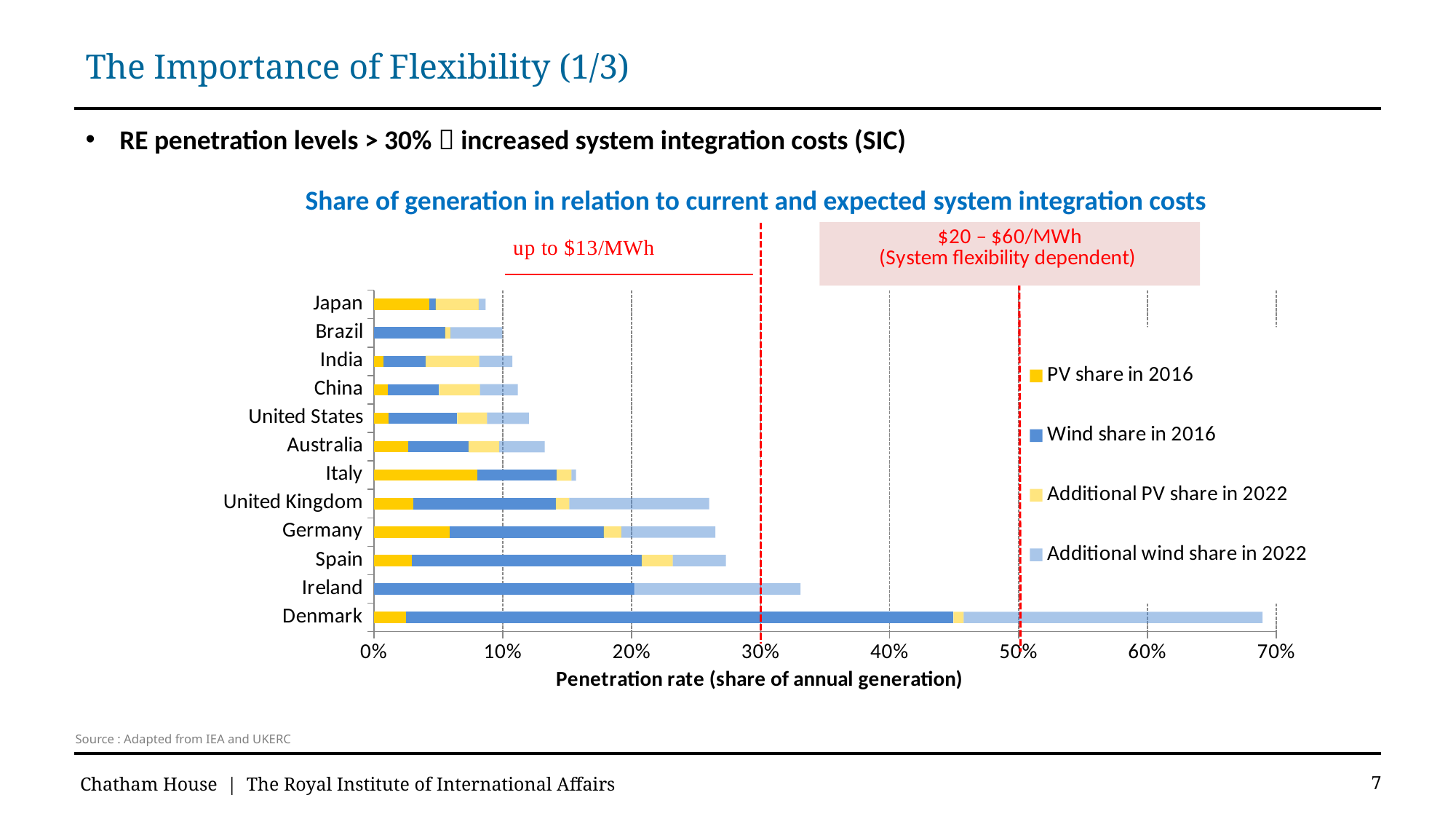
Is the total penetration rate for Japan greater or less than 10%? less How many series does the legend list? 4 Which has a larger total penetration rate, Ireland or Spain? Ireland Is the total penetration rate for Spain greater or less than 30%? less Is the total penetration rate for Ireland greater or less than 30%? greater What is the label of the x axis? Penetration rate (share of annual generation) Which has a larger total penetration rate, the United Kingdom or Italy? United Kingdom What kind of chart is shown on the slide? Stacked bar chart How many countries are listed on the chart? 12 Which country has the highest total penetration rate? Denmark